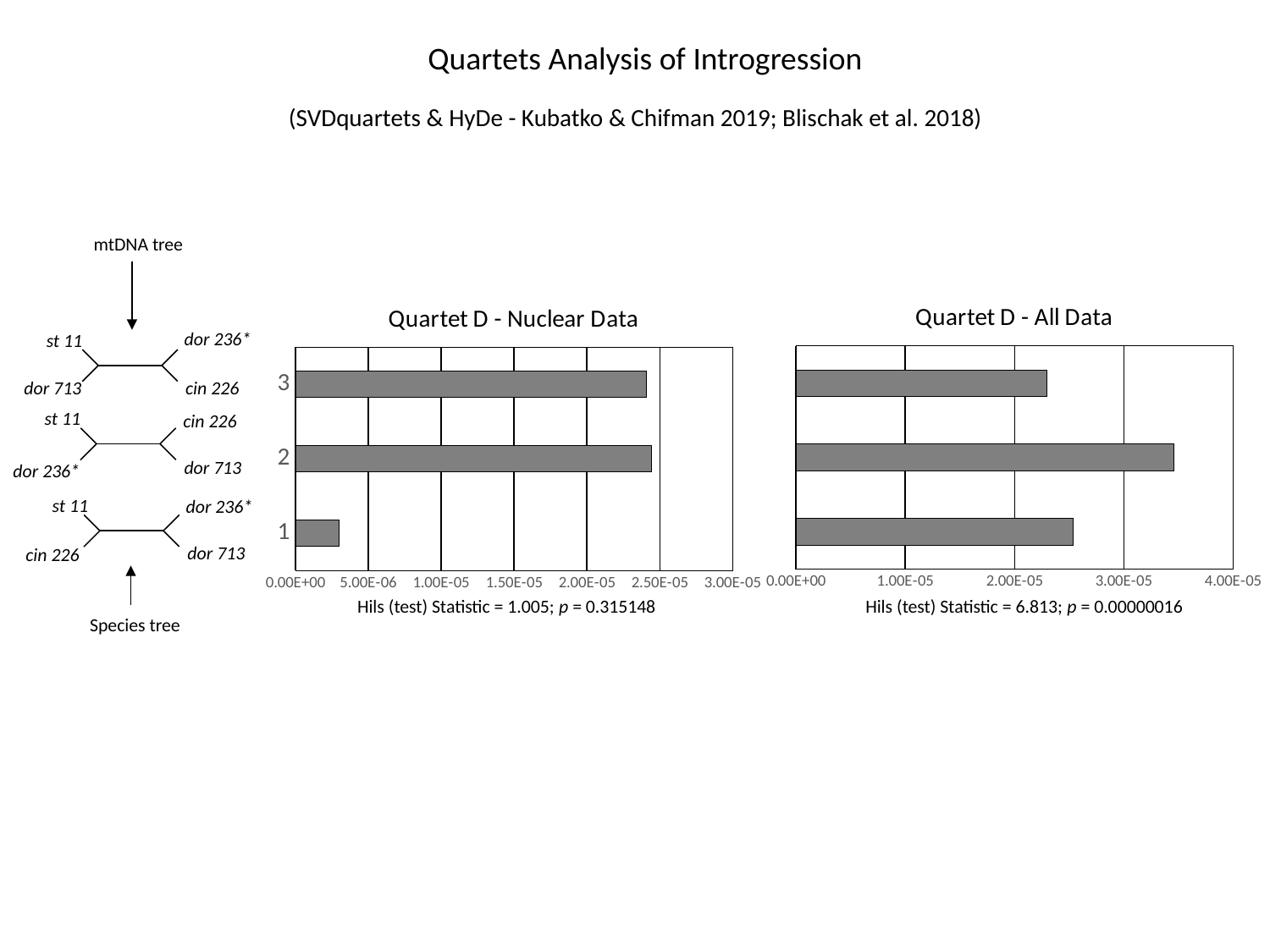
How many categories are plotted in the "Quartet D - All Data" chart? 3 In the "Quartet D - All Data" chart, is the value for category 1 greater or less than 3.00E-05? less In the "Quartet D - All Data" chart, is the value for category 2 greater or less than 3.00E-05? greater What kind of chart is "Quartet D - Nuclear Data"? bar chart What is the maximum value shown on the x axis of the "Quartet D - All Data" chart? 4.00E-05 In the "Quartet D - Nuclear Data" chart, is the value for category 1 greater or less than 5.00E-06? less In the "Quartet D - Nuclear Data" chart, which category has the lowest value? 1 In the "Quartet D - All Data" chart, which is larger, the value for category 2 or category 3? category 2 In the "Quartet D - All Data" chart, which category has the highest value? 2 What is the title of the chart on the left? Quartet D - Nuclear Data In the "Quartet D - Nuclear Data" chart, which is larger, the value for category 2 or category 1? category 2